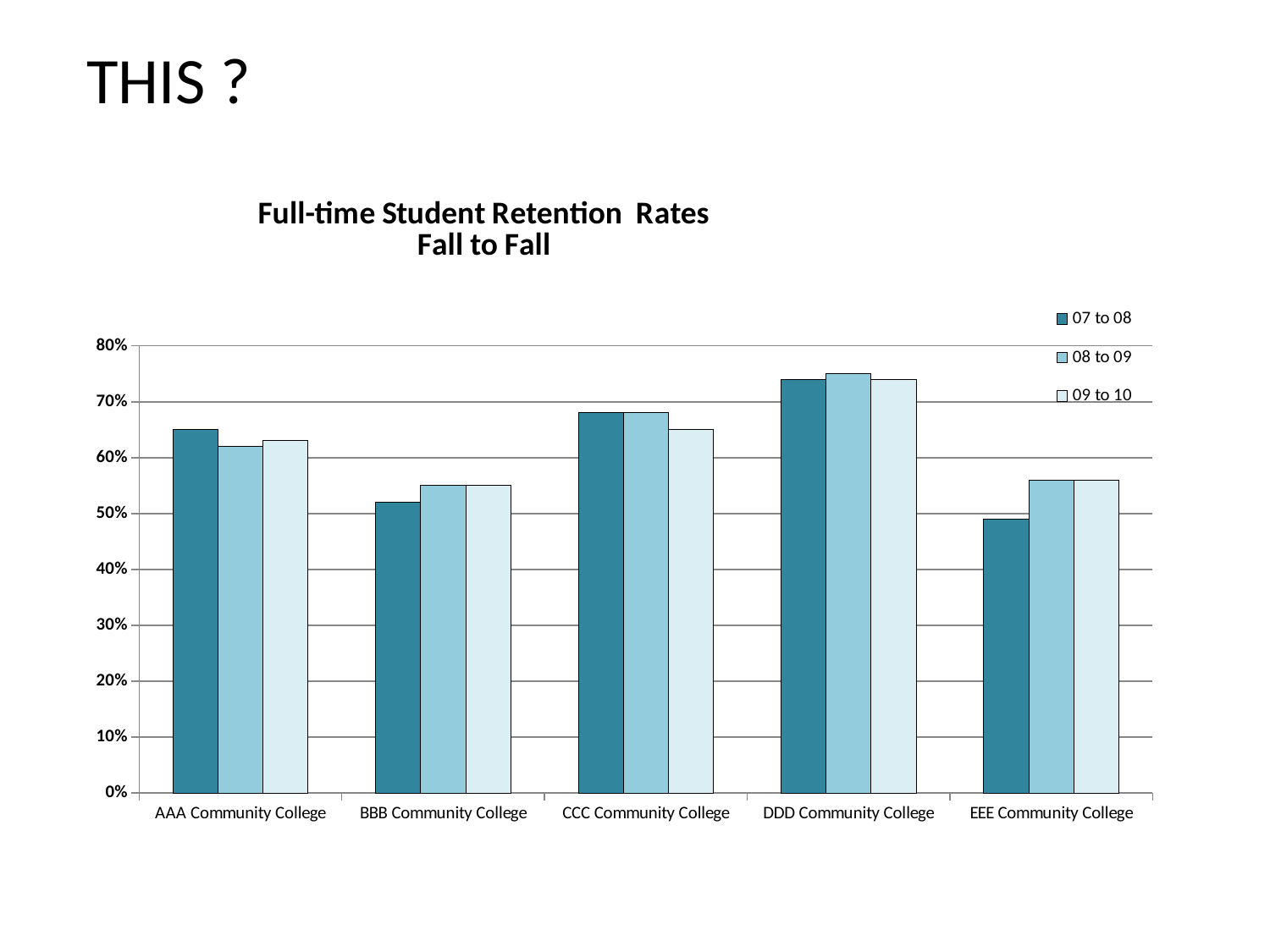
Is the 08 to 09 value for DDD Community College greater or less than 70%? greater Which community college has the highest 07 to 08 retention rate? DDD Community College How many community colleges are shown on the x axis? 5 Is the 09 to 10 value for CCC Community College greater or less than 60%? greater How many series does the legend list? 3 Which community college has the highest 08 to 09 retention rate? DDD Community College Which is larger, the 07 to 08 value for AAA Community College or the 07 to 08 value for BBB Community College? AAA Community College Is the 07 to 08 value for AAA Community College greater or less than 60%? greater Which is larger, the 07 to 08 value for DDD Community College or the 07 to 08 value for EEE Community College? DDD Community College What type of chart is shown on the slide? bar chart What is the title of the chart? Full-time Student Retention Rates Fall to Fall